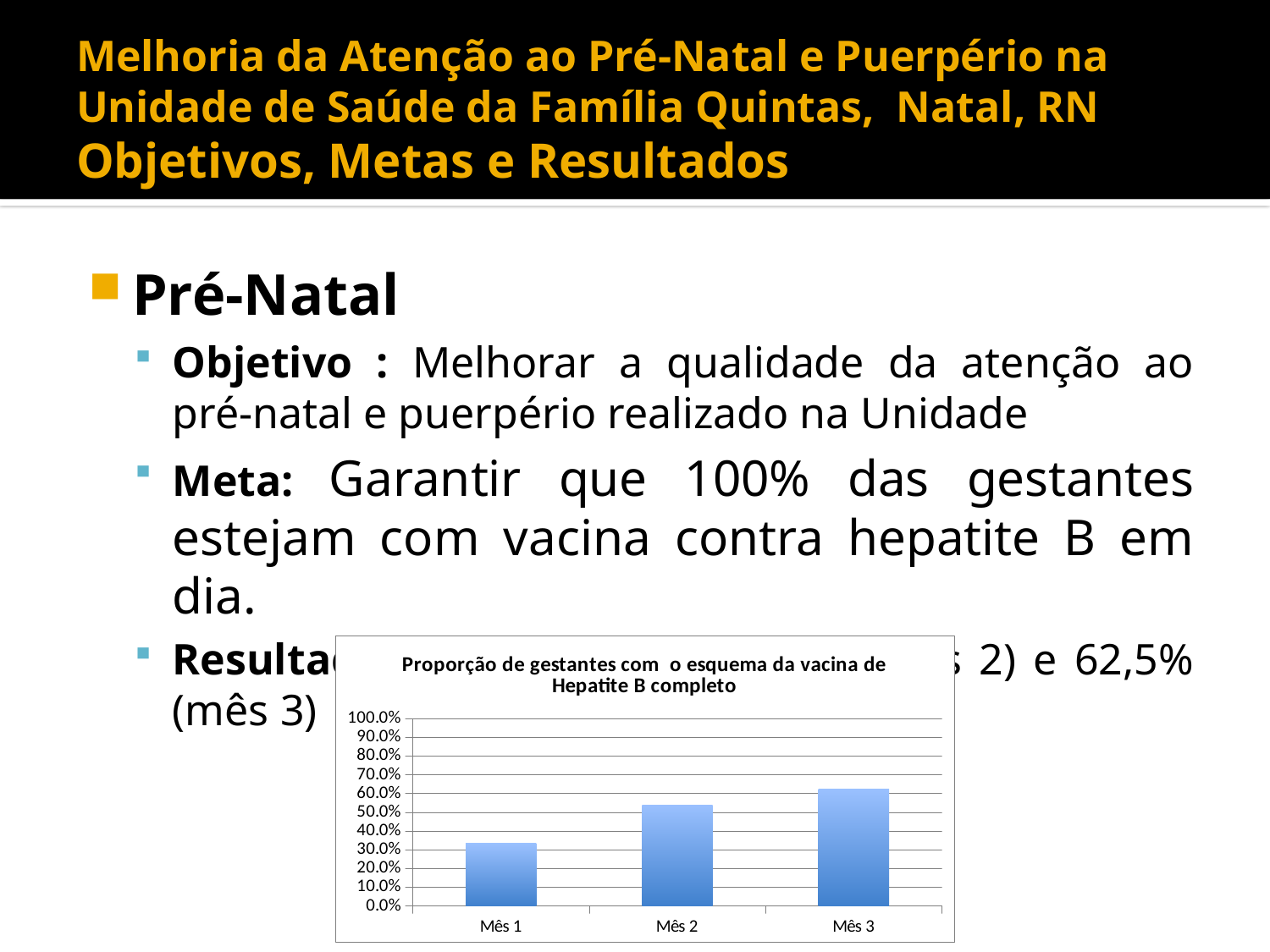
What kind of chart is shown on the slide? bar chart Which month has the highest proportion in the chart? Mês 3 Which is larger, the value for Mês 1 or the value for Mês 2? Mês 2 How many categories (months) are plotted in the chart? 3 What is the title of the chart? Proporção de gestantes com o esquema da vacina de Hepatite B completo Is the value for Mês 3 greater or less than 70.0%? less What is the highest value shown on the chart's vertical axis? 100.0% Which month has the lowest proportion in the chart? Mês 1 Is the value for Mês 1 greater or less than 40.0%? less Is the value for Mês 1 greater or less than 30.0%? greater Do the values rise or fall from Mês 1 to Mês 3? rise